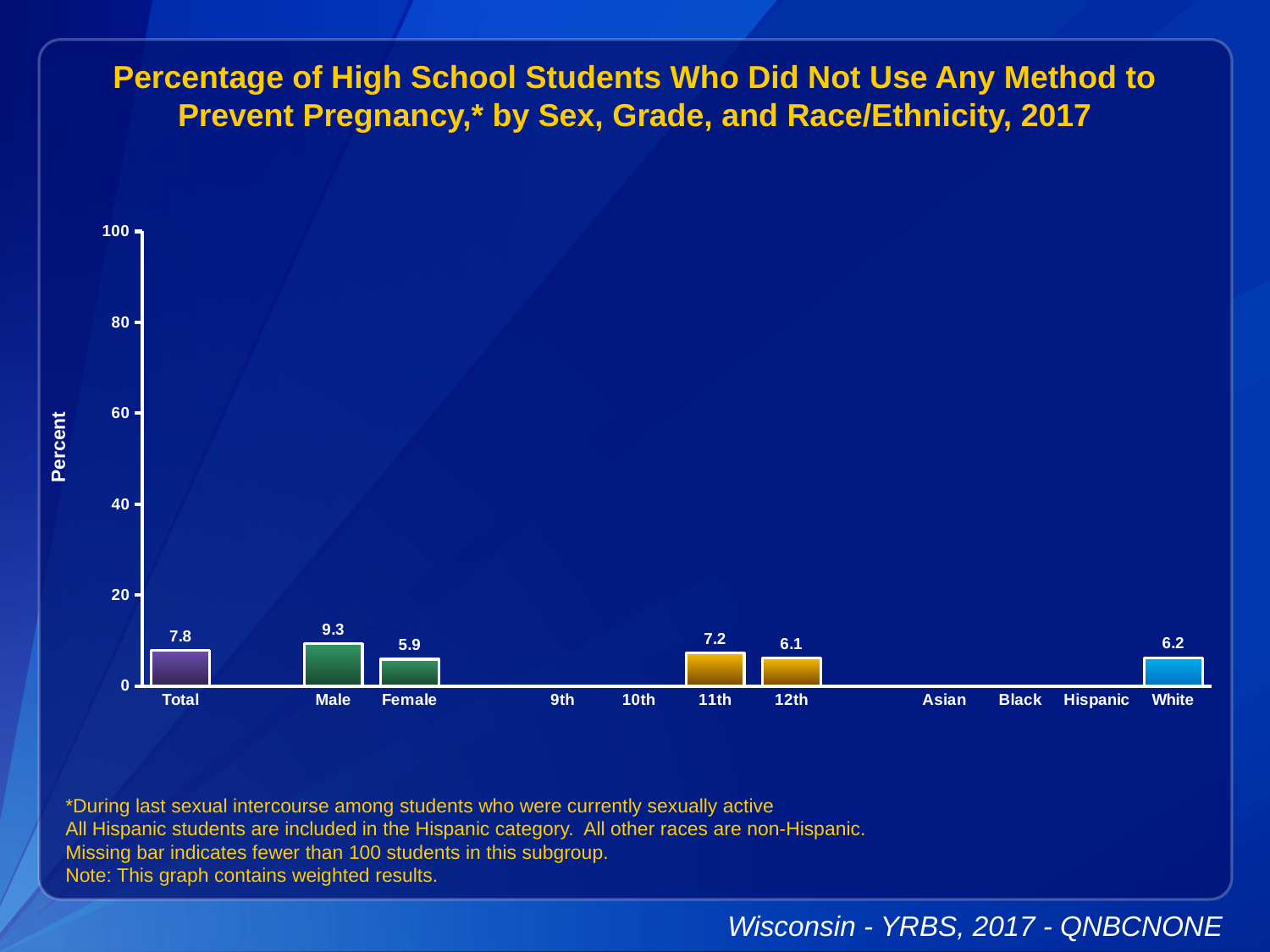
Is the value for Male greater or less than 20? less What is the value for Male? 9.3 What is the difference between the Male and Female values? 3.4 How many categories have a bar shown? 6 What is the value for White? 6.2 Which category has the highest value? Male Which is larger, the value for 11th grade or 12th grade? 11th What is the value for Female? 5.9 What is the value for Total? 7.8 What is the value for 11th grade? 7.2 What kind of chart is this? bar chart Which category with a bar has the lowest value? Female